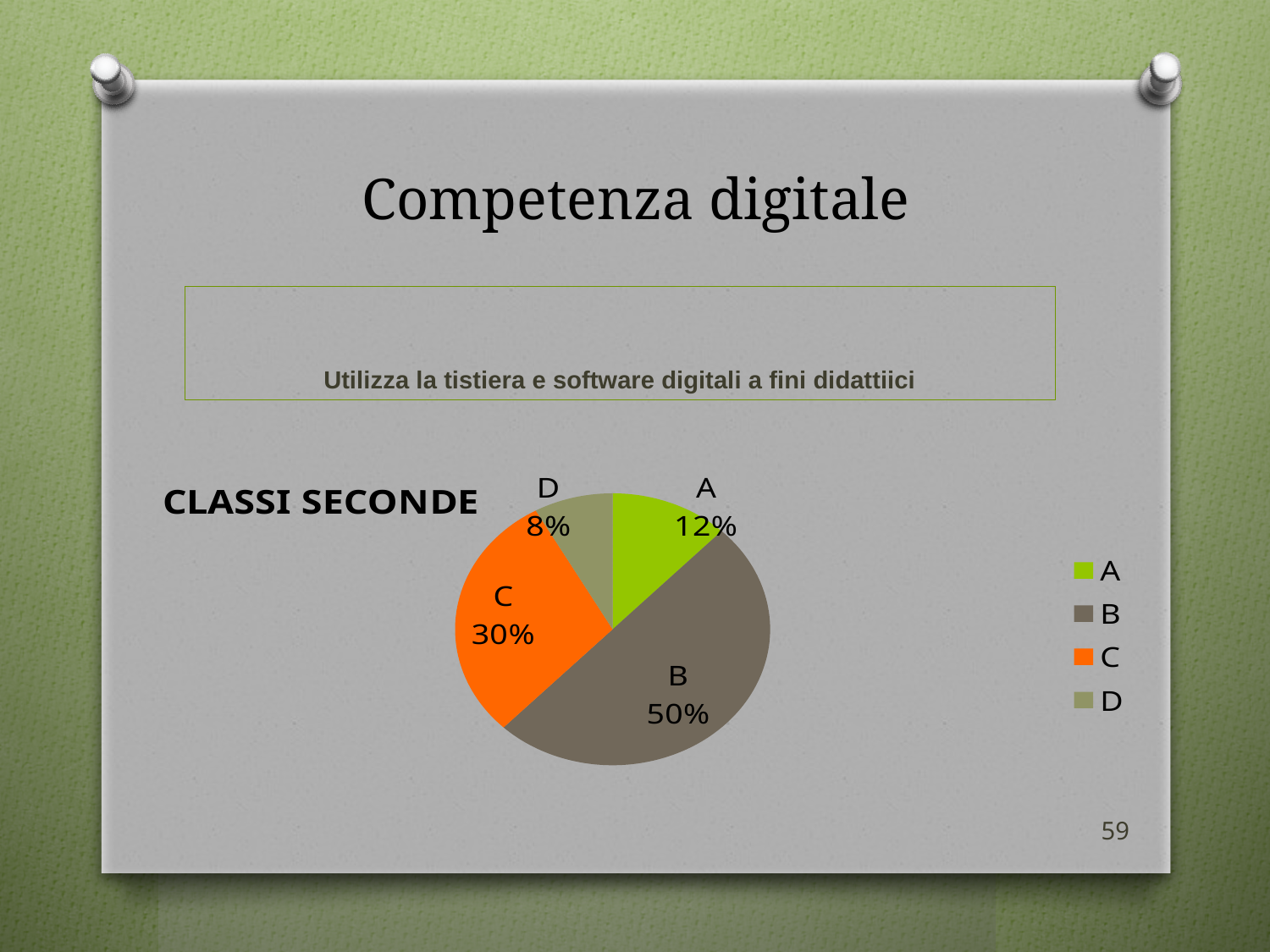
How many entries does the legend list? 4 What is the difference in percentage points between slice B and slice C? 20 Which category has the smallest slice of the pie chart? D What percentage does slice C represent in the pie chart? 30% Which category has the largest slice of the pie chart? B How many slices does the pie chart have? 4 What colour is slice C in the pie chart? orange What kind of chart is shown on the slide? pie chart What percentage does slice A represent in the pie chart? 12% What percentage does slice B represent in the pie chart? 50% Which is larger, slice A or slice D? A What percentage does slice D represent in the pie chart? 8%